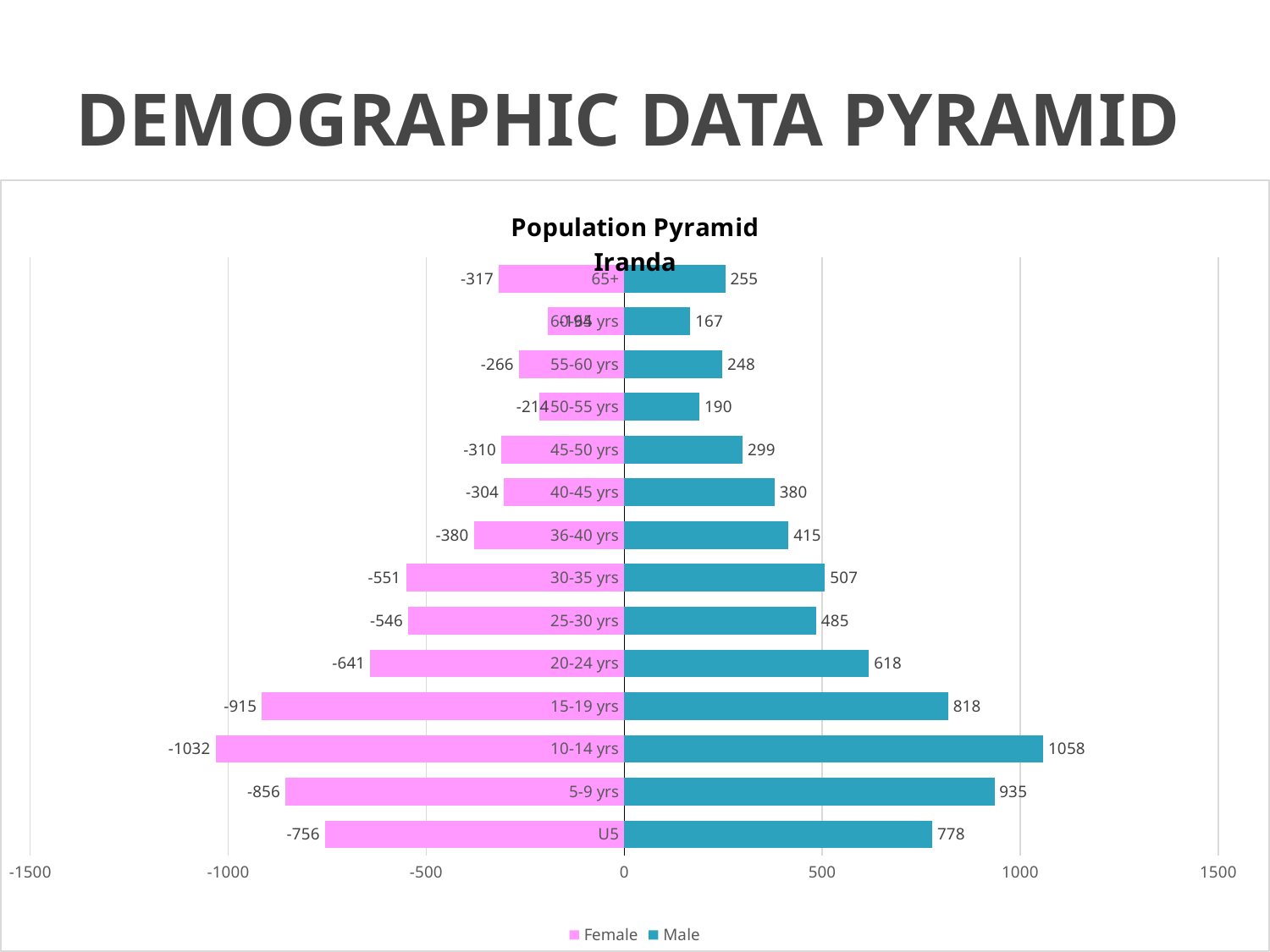
How many age groups are shown on the chart? 14 Is the Male value for 15-19 yrs greater or less than 500? greater What kind of chart is shown on the slide? bar chart Which colour represents the Female series? pink Which is larger, the Male value for 30-35 yrs or the Male value for 36-40 yrs? 30-35 yrs Which age group has the lowest Male value? 60-65 yrs What is the Female value shown for the 15-19 yrs age group? -915 Which age group has the highest Male value? 10-14 yrs How many series does the legend list? 2 What is the difference between the Male values for 5-9 yrs and 20-24 yrs? 317 What is the Male value for the U5 age group? 778 What is the Male value for the 10-14 yrs age group? 1058